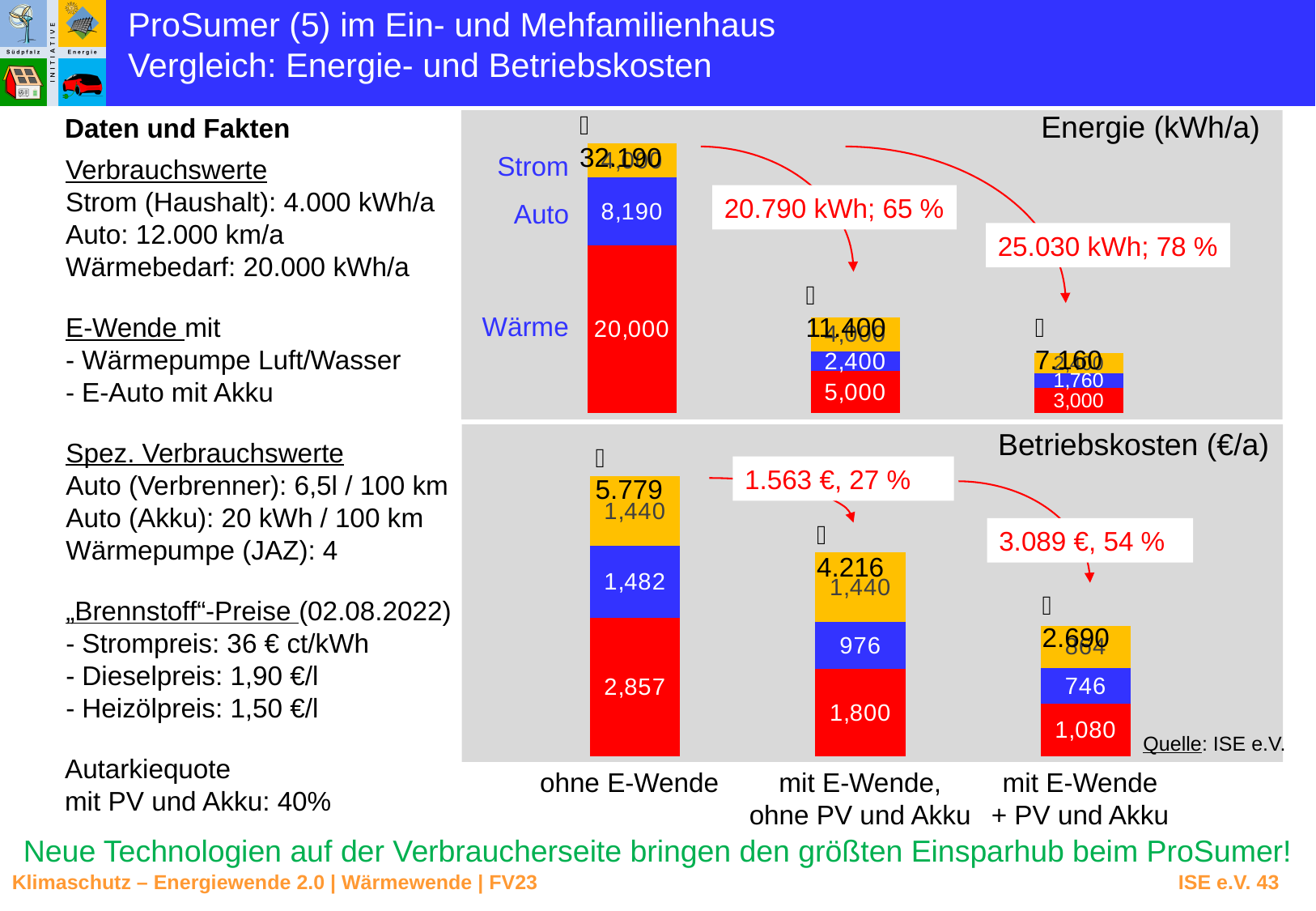
In the Betriebskosten (€/a) chart, what is the Auto value for 'mit E-Wende + PV und Akku'? 746 In the Betriebskosten (€/a) chart, what is the Wärme value for 'ohne E-Wende'? 2,857 In the Energie (kWh/a) chart, what is the Auto value for 'ohne E-Wende'? 8,190 In the Energie (kWh/a) chart, what is the Wärme value for 'mit E-Wende + PV und Akku'? 3,000 In the Betriebskosten (€/a) chart, what is the total of the stacked bar for 'ohne E-Wende'? 5.779 What kind of chart is the Betriebskosten (€/a) chart? stacked bar chart How many categories are shown along the x axis of the Energie (kWh/a) chart? 3 In the Energie (kWh/a) chart, what is the difference between the Wärme values for 'ohne E-Wende' and 'mit E-Wende, ohne PV und Akku'? 15,000 In the Energie (kWh/a) chart, what is the total of the stacked bar for 'mit E-Wende, ohne PV und Akku'? 11.400 In the Energie (kWh/a) chart, what is the Wärme value for 'ohne E-Wende'? 20,000 In the Betriebskosten (€/a) chart, do the stacked bar totals rise or fall from left to right? fall In the Betriebskosten (€/a) chart, which is larger: the Auto value for 'ohne E-Wende' or the Auto value for 'mit E-Wende, ohne PV und Akku'? ohne E-Wende